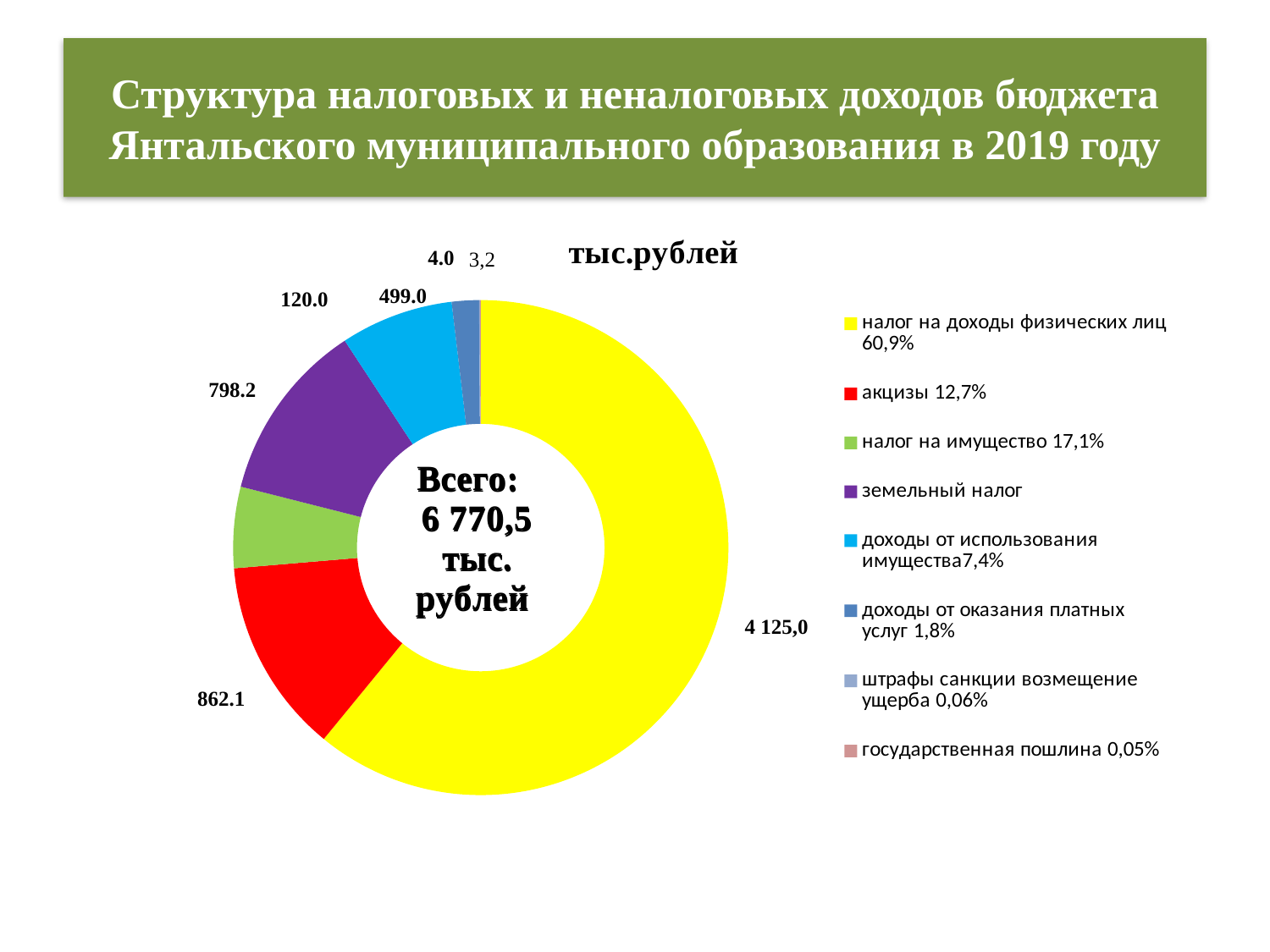
According to the legend, what share of the total is налог на доходы физических лиц? 60,9% What unit is stated above the doughnut chart? тыс.рублей What is the smallest value labelled on the doughnut chart? 3,2 Which is larger: the value for налог на доходы физических лиц or the value for акцизы? налог на доходы физических лиц How many categories does the legend list? 8 What value is labelled for the yellow slice (налог на доходы физических лиц)? 4 125,0 What value is labelled for the red slice (акцизы)? 862.1 What is the largest value labelled on the doughnut chart? 4 125,0 According to the legend, what share of the total is акцизы? 12,7% Which category has the largest slice in the doughnut chart? налог на доходы физических лиц What is the total shown in the centre of the doughnut chart? 6 770,5 тыс. рублей What type of chart is shown on the slide? Doughnut (pie) chart